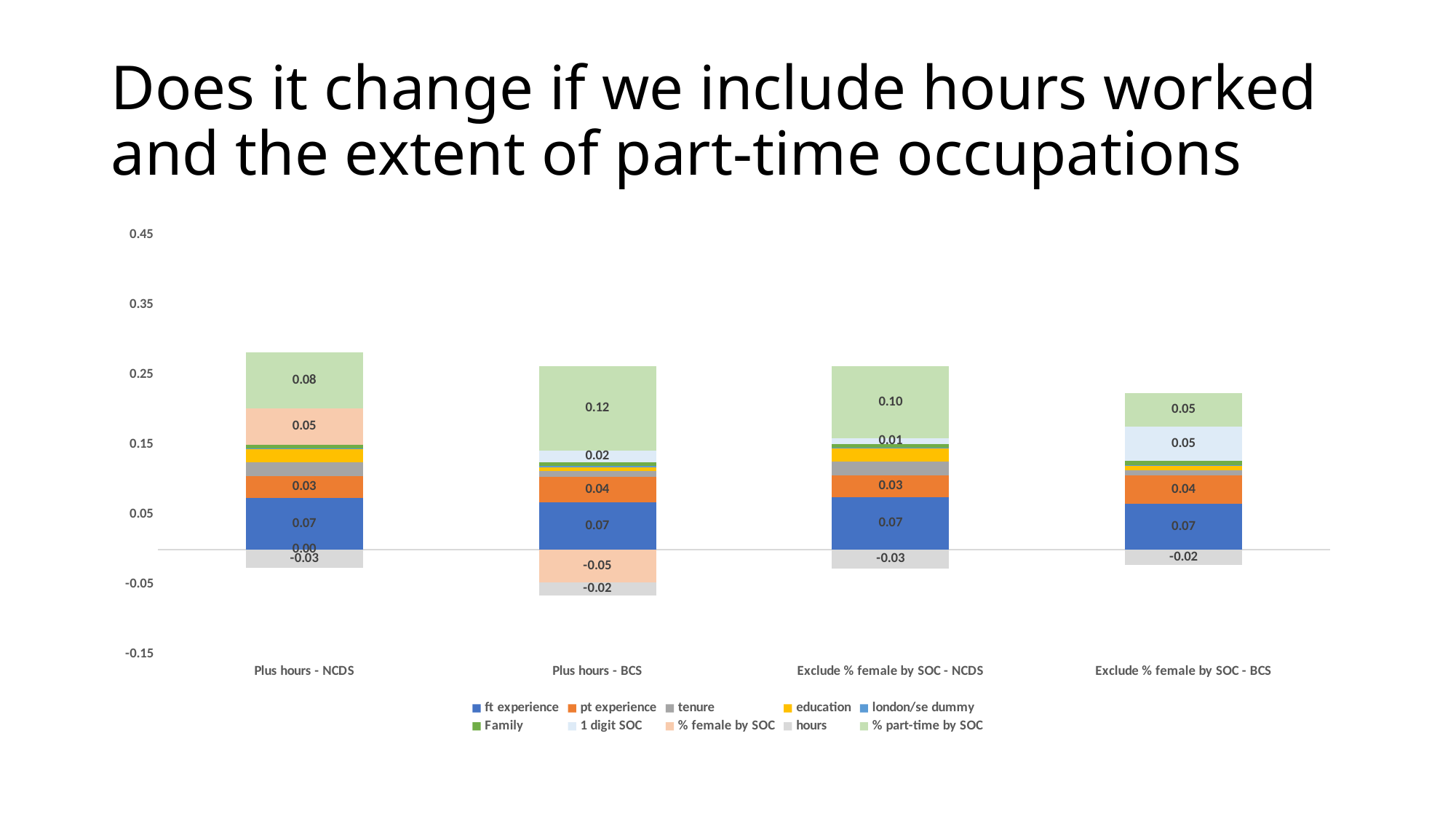
What is the value of % part-time by SOC for Plus hours - BCS? 0.12 How many series does the chart's legend list? 10 What is the value of 1 digit SOC for Exclude % female by SOC - BCS? 0.05 What kind of chart is shown on the slide? Stacked bar chart Which category has the largest % part-time by SOC value? Plus hours - BCS Is the top of the stacked bar for Plus hours - NCDS greater or less than 0.25? greater Which has the larger pt experience value, Plus hours - NCDS or Plus hours - BCS? Plus hours - BCS How many categories are shown along the x axis of the chart? 4 What is the difference in % part-time by SOC between Plus hours - BCS and Exclude % female by SOC - BCS? 0.07 What is the value of % female by SOC for Plus hours - BCS? -0.05 What colour represents % part-time by SOC in the legend? Light green What is the value of hours for Plus hours - NCDS? -0.03